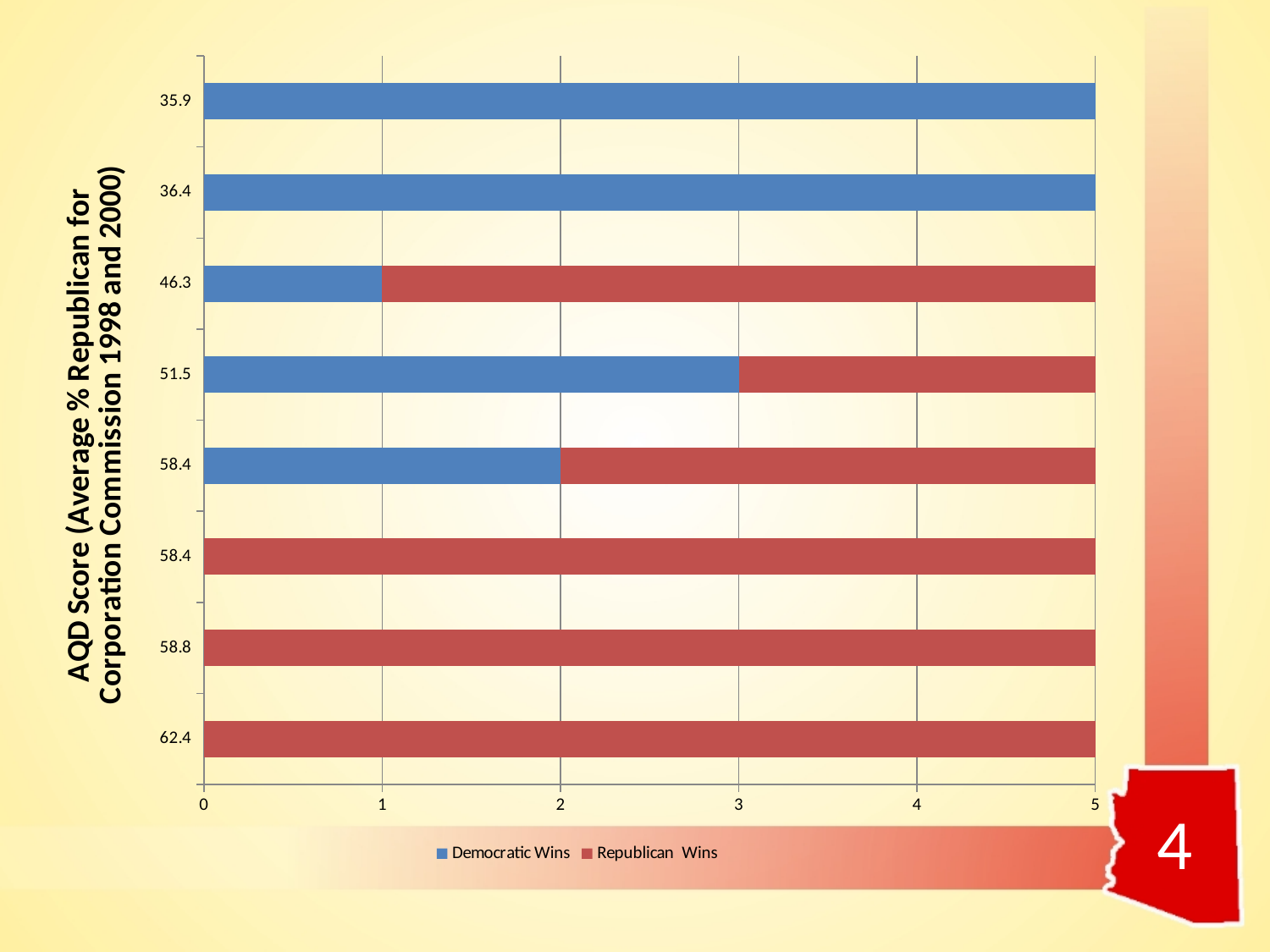
What is the Republican Wins value for the AQD score 62.4? 5 What kind of chart is shown on the slide? Stacked bar chart What is the difference between Republican Wins and Democratic Wins for the AQD score 46.3? 3 For the AQD score 46.3, which is larger, Democratic Wins or Republican Wins? Republican Wins What is the Republican Wins value for the AQD score 46.3? 4 How many series does the legend list? 2 What is the Democratic Wins value for the AQD score 46.3? 1 What is the total of the stacked bar for the AQD score 51.5? 5 What is the Democratic Wins value for the AQD score 35.9? 5 How many categories (AQD scores) are plotted on the y axis? 8 What is the y-axis title of the chart? AQD Score (Average % Republican for Corporation Commission 1998 and 2000) What is the Democratic Wins value for the AQD score 51.5? 3